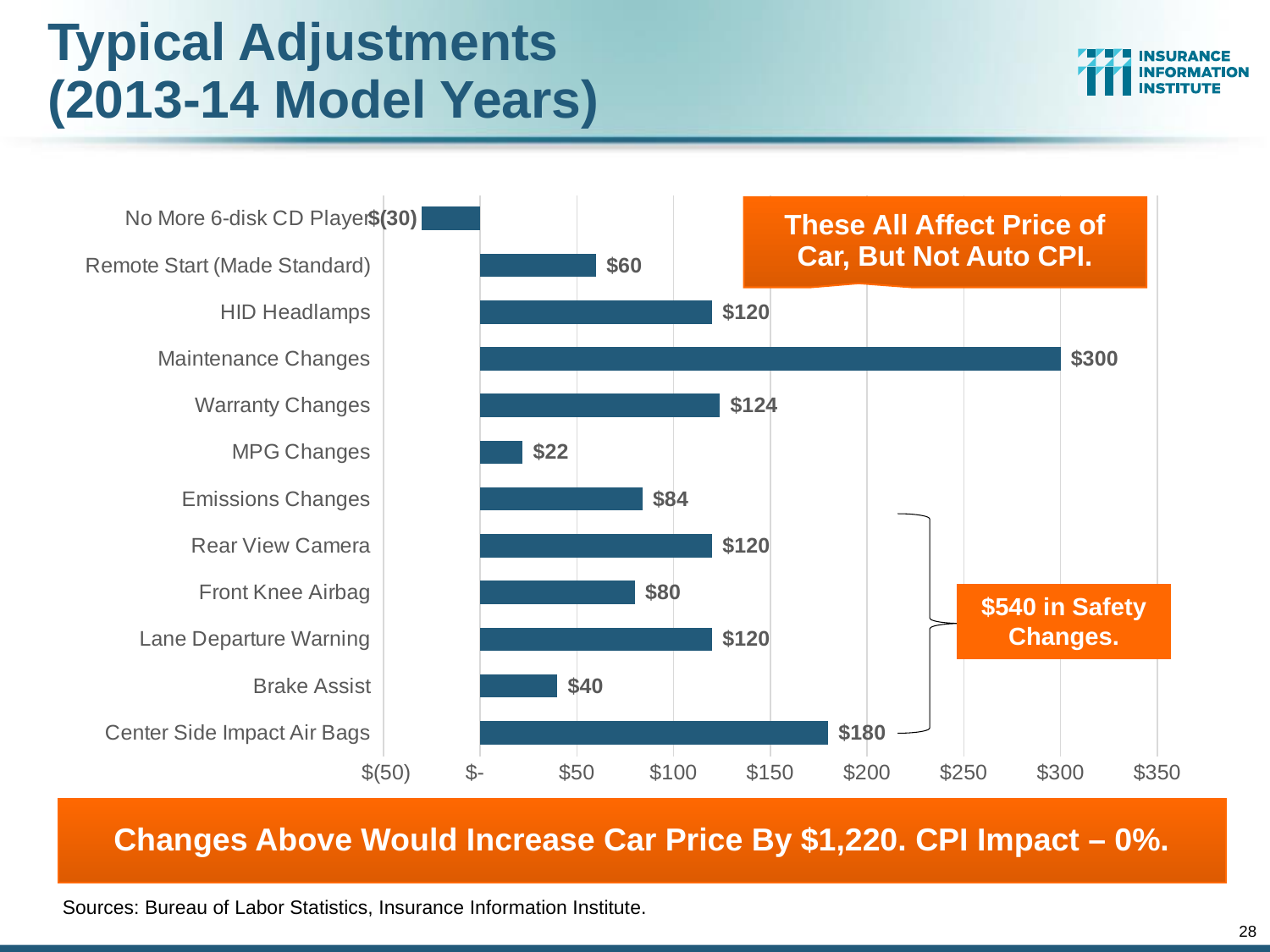
What is the difference between Maintenance Changes and Center Side Impact Air Bags? $120 Is the value for Emissions Changes greater or less than $100? less What kind of chart is shown on the slide? bar chart What is the value for Center Side Impact Air Bags? $180 Which category has the highest value? Maintenance Changes What is the value for No More 6-disk CD Player? $(30) What is the value for Maintenance Changes? $300 Which category has the lowest value? No More 6-disk CD Player What is the value for MPG Changes? $22 How many categories are shown in the chart? 12 According to the callout on the chart, how much do the safety changes total? $540 Which is larger, Warranty Changes or HID Headlamps? Warranty Changes